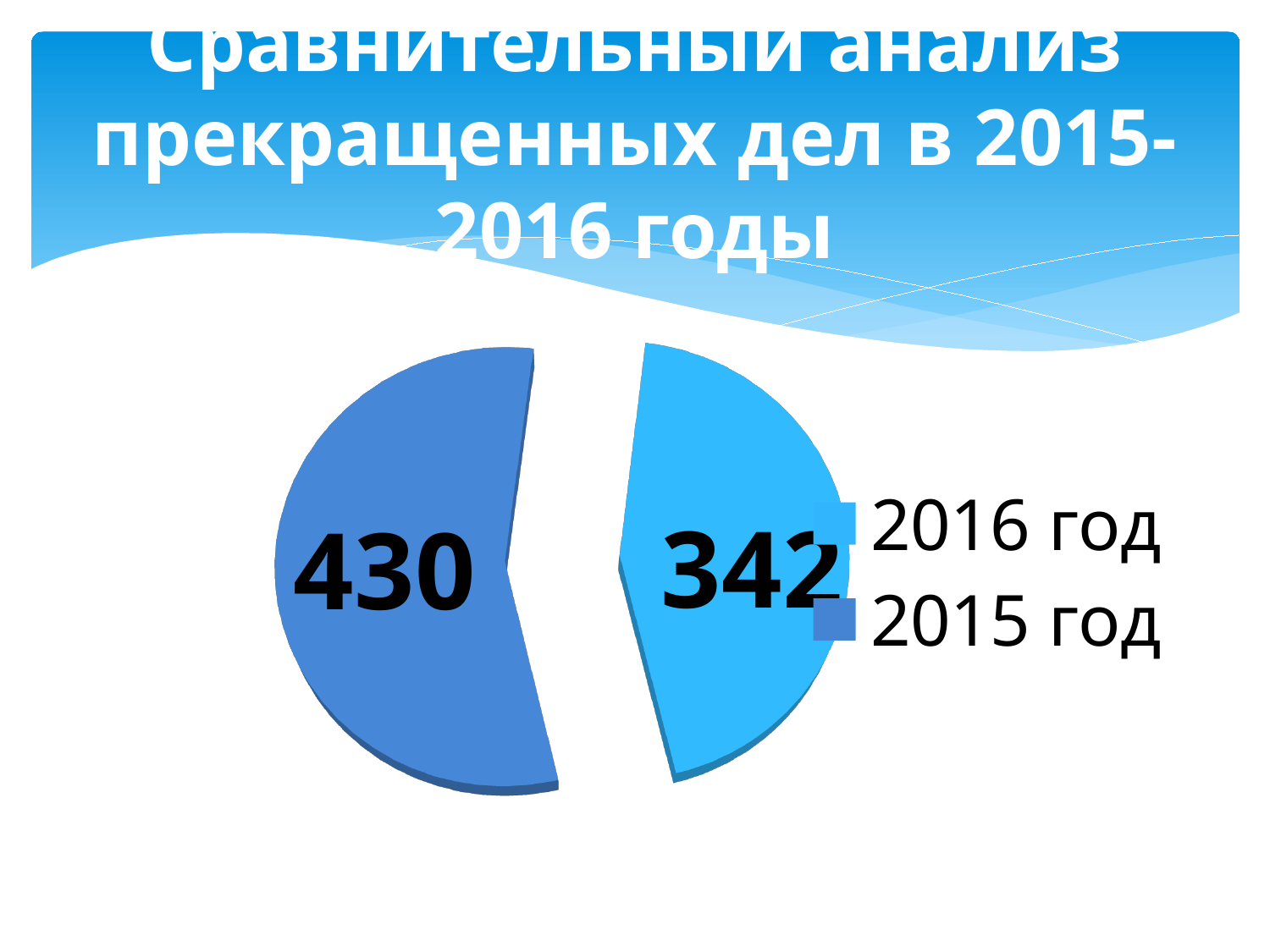
What is the total of the two slices in the pie chart? 772 Which year has the smaller slice of the pie? 2016 год What kind of chart is shown on the slide? pie chart How many slices does the pie chart have? 2 What is the difference between the values for 2015 год and 2016 год? 88 How many entries does the legend list? 2 Which year has the larger slice of the pie? 2015 год Which legend entry is shown in the lighter blue colour? 2016 год What is the value for 2016 год? 342 What is the title of the slide containing the chart? Сравнительный анализ прекращенных дел в 2015-2016 годы Which is larger, the value for 2015 год or the value for 2016 год? 2015 год What is the value for 2015 год? 430